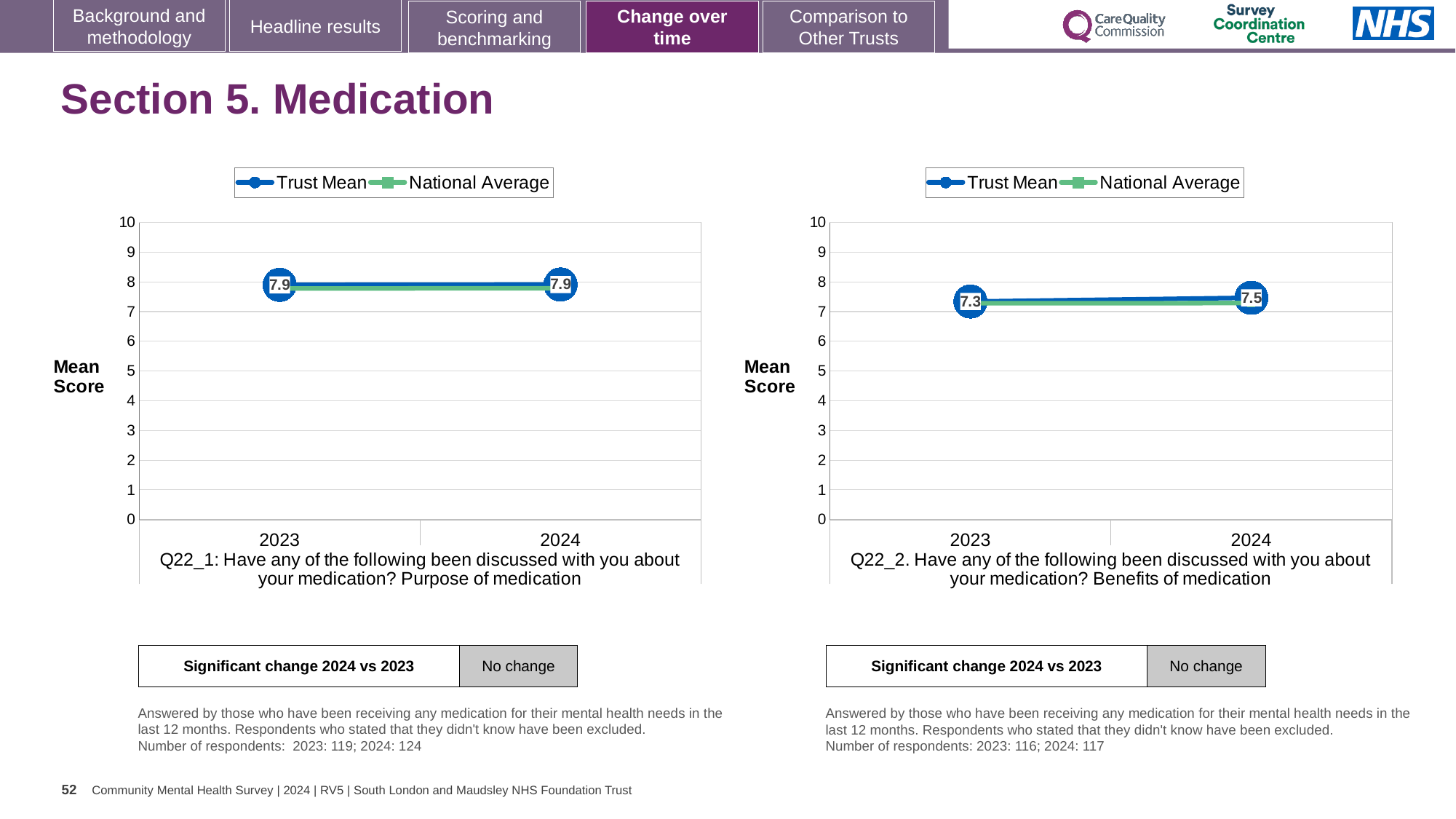
In the left chart (Q22_1: Purpose of medication), is the National Average for 2024 greater or less than 5? greater In the right chart (Q22_2: Benefits of medication), what is the Trust Mean for 2024? 7.5 What is the label of the y axis on the right chart (Q22_2: Benefits of medication)? Mean Score In the left chart (Q22_1: Purpose of medication), what is the Trust Mean for 2023? 7.9 In the left chart (Q22_1: Purpose of medication), what is the Trust Mean for 2024? 7.9 What kind of chart is the left chart (Q22_1: Purpose of medication)? line chart In the right chart (Q22_2: Benefits of medication), what is the Trust Mean for 2023? 7.3 How many years are shown on the x axis of the right chart (Q22_2: Benefits of medication)? 2 In the right chart (Q22_2: Benefits of medication), which year has the higher Trust Mean, 2023 or 2024? 2024 How many series does the legend of the left chart (Q22_1: Purpose of medication) list? 2 In the right chart (Q22_2: Benefits of medication), does the Trust Mean rise or fall from 2023 to 2024? rise In the right chart (Q22_2: Benefits of medication), what is the difference between the Trust Mean for 2024 and 2023? 0.2